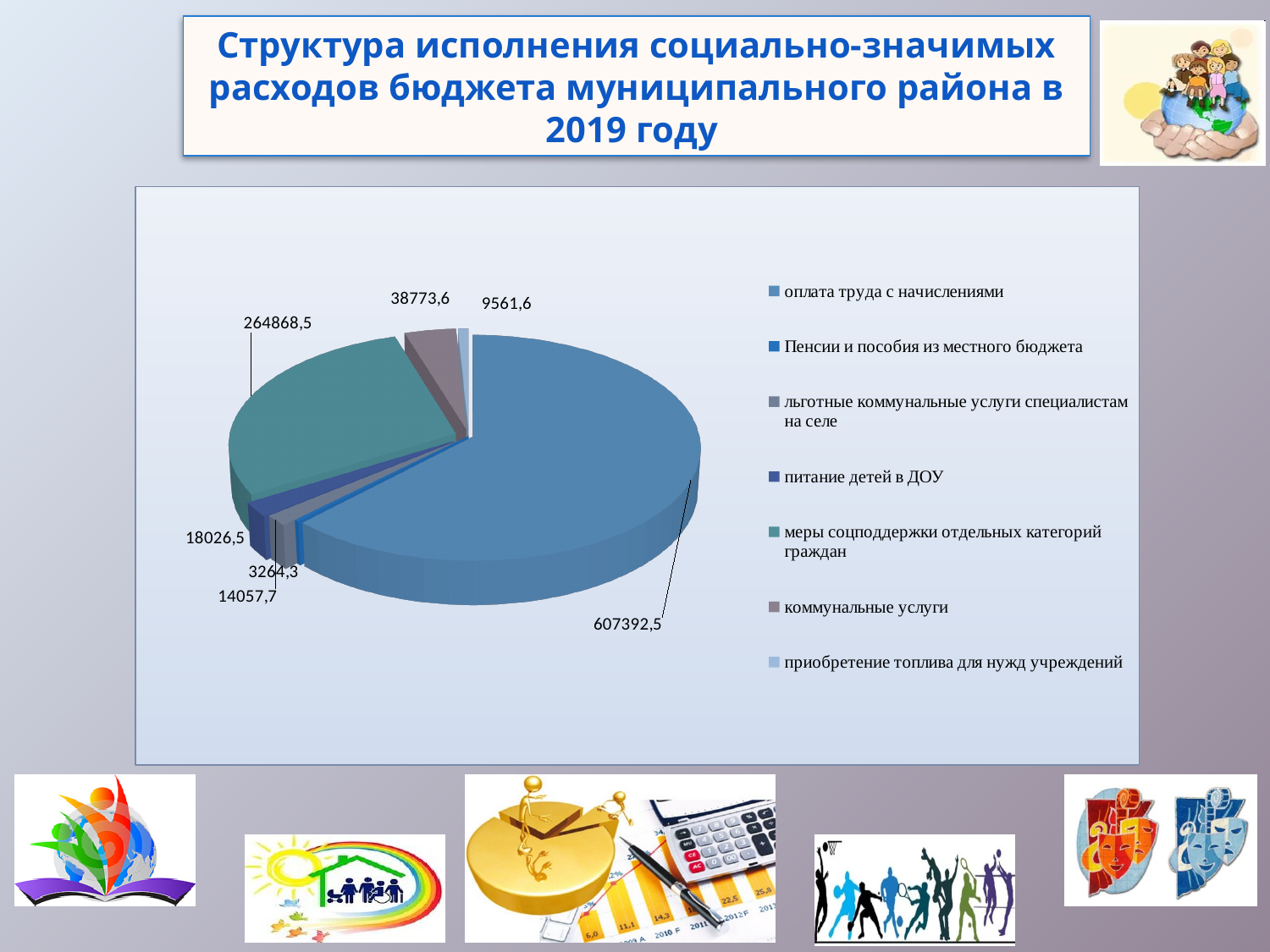
What is the value for 'меры соцподдержки отдельных категорий граждан'? 264868,5 What is the value for 'коммунальные услуги'? 38773,6 How many slices does the pie chart have? 7 What is the smallest value labelled on the pie chart? 3264,3 Which category has the largest slice in the pie chart? оплата труда с начислениями Which is larger: the value for 'коммунальные услуги' or the value for 'приобретение топлива для нужд учреждений'? коммунальные услуги Which year does the slide title say the chart refers to? 2019 What is the value for 'приобретение топлива для нужд учреждений'? 9561,6 How many entries does the legend of the pie chart list? 7 What kind of chart is shown on the slide? pie chart What is the difference between the values for 'оплата труда с начислениями' and 'меры соцподдержки отдельных категорий граждан'? 342524 What is the value of the largest slice in the pie chart? 607392,5